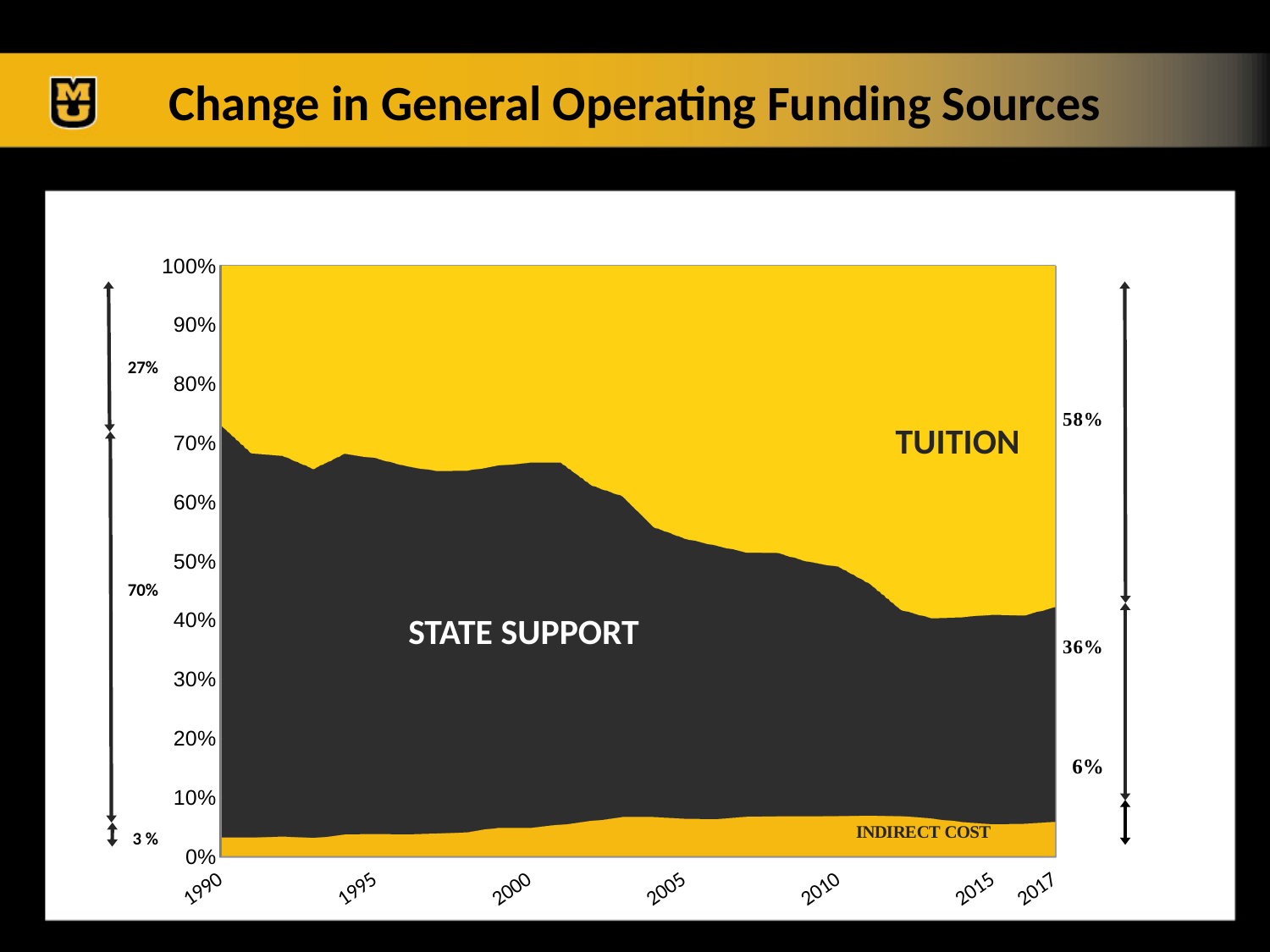
How many funding sources are shown in the chart? 3 What share of general operating funding came from tuition in 2017? 58% Does the state support share rise or fall from 1990 to 2017? Fall What kind of chart is shown on the slide? Stacked area chart What share of general operating funding came from tuition in 1990? 27% What share of general operating funding came from indirect cost in 1990? 3% Which funding source was the largest in 2017? Tuition What is the title of the chart? Change in General Operating Funding Sources What share of general operating funding came from state support in 2017? 36% What share of general operating funding came from state support in 1990? 70% By how many percentage points did the tuition share increase from 1990 to 2017? 31 What share of general operating funding came from indirect cost in 2017? 6%